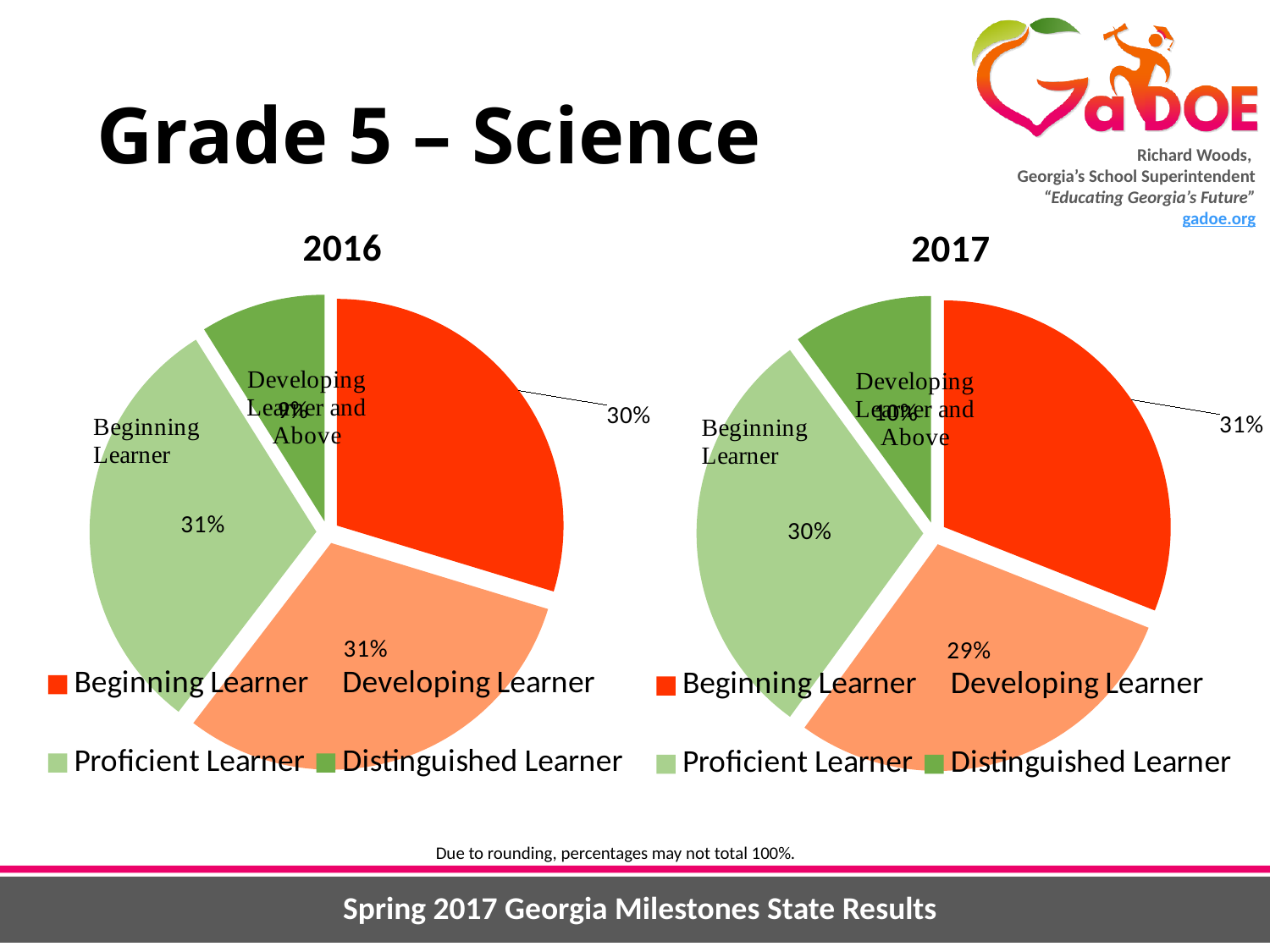
In the 2017 pie chart, what is the difference in percentage points between Beginning Learner and Developing Learner? 2 What kind of chart is used for the 2016 and 2017 results on this slide? Pie chart In the 2017 pie chart, which slice is the smallest? Distinguished Learner In the 2016 pie chart, what percentage is shown for Developing Learner? 31% In the 2017 pie chart, what share of the pie is Proficient Learner? 30% How many entries does the legend under the 2017 pie chart list? 4 In the 2017 pie chart, what percentage is shown for Developing Learner? 29% In the 2017 pie chart, what percentage is shown for Beginning Learner? 31% How many slices does the 2016 pie chart have? 4 In the 2016 pie chart, what percentage is shown for Proficient Learner? 31% In the 2016 pie chart, what percentage is shown for Beginning Learner? 30% In the 2017 pie chart, which is larger, Beginning Learner or Developing Learner? Beginning Learner